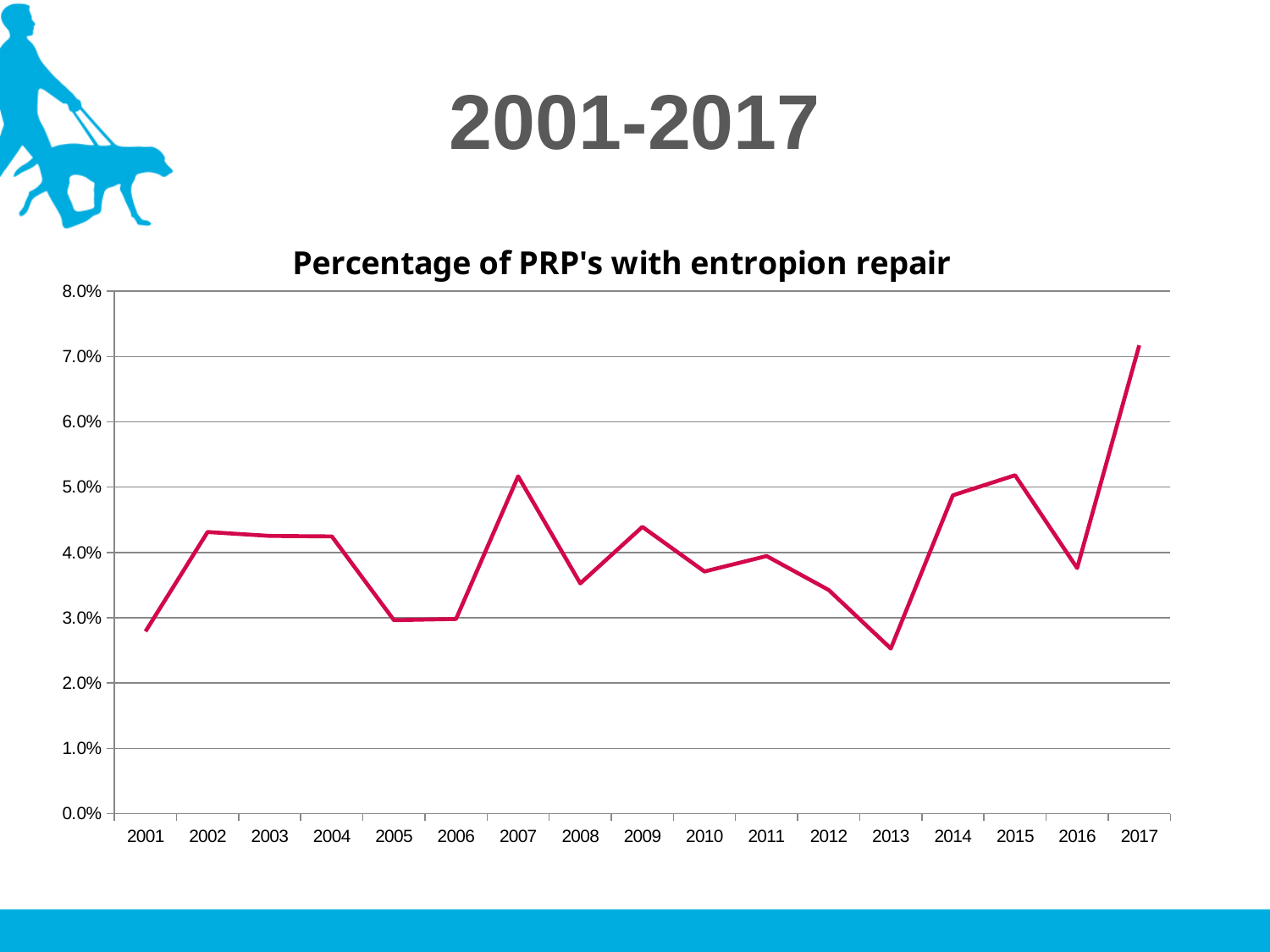
Is the value for 2014 greater or less than 4.0%? greater What is the title of the chart? Percentage of PRP's with entropion repair Is the value for 2012 greater or less than 4.0%? less Does the percentage rise or fall from 2013 to 2017? rise How many years are plotted on the x axis of the chart? 17 Which year has the lowest percentage of PRP's with entropion repair? 2013 Which year has the highest percentage of PRP's with entropion repair? 2017 Which year has the larger value, 2007 or 2008? 2007 Is the value for 2017 greater or less than 6.0%? greater Which year has the larger value, 2015 or 2016? 2015 What kind of chart is shown on the slide? line chart